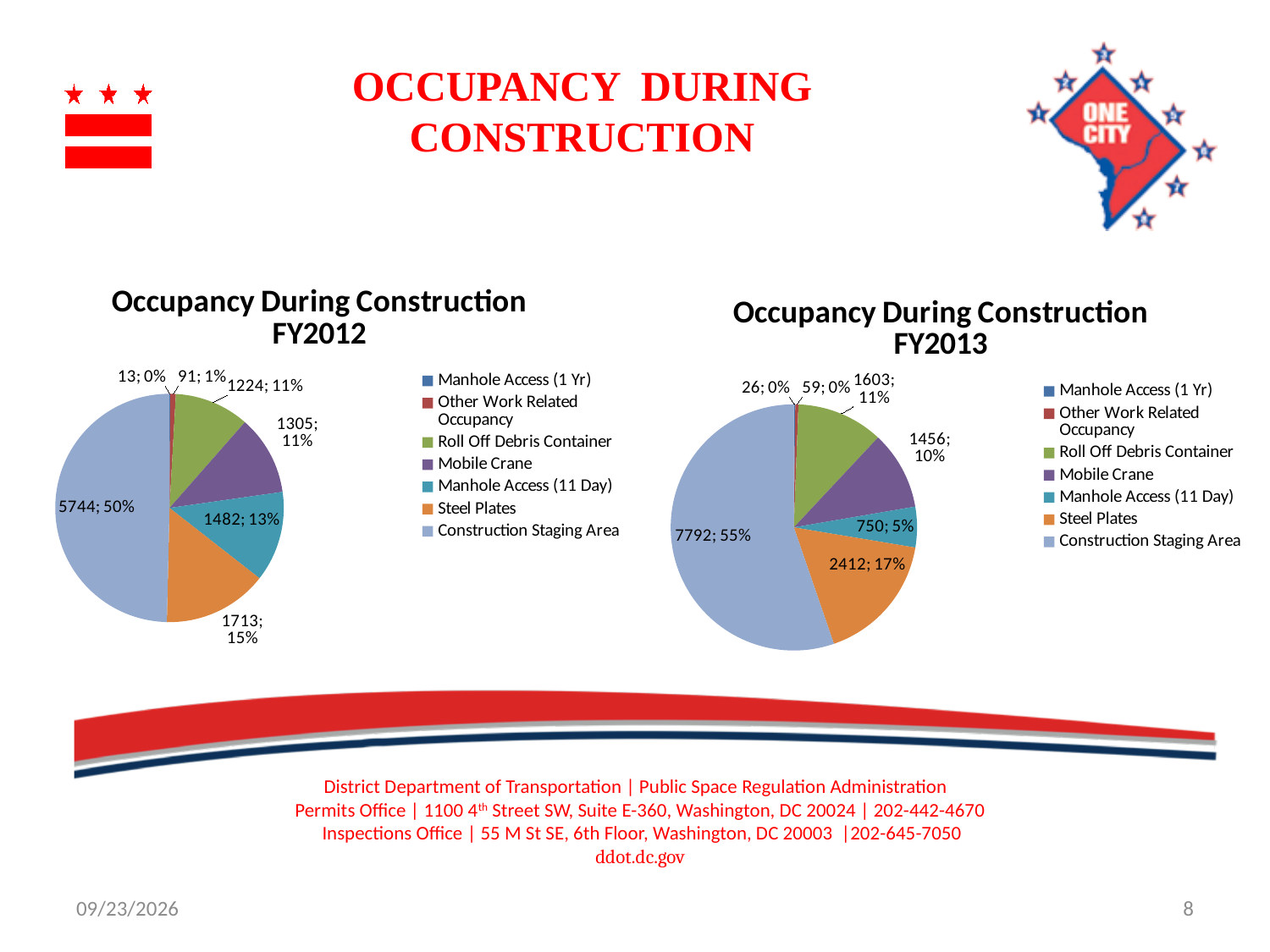
What type of chart is used for Occupancy During Construction FY2012? Pie chart In the Occupancy During Construction FY2012 chart, what is the difference between the Steel Plates value and the Manhole Access (11 Day) value? 231 In the Occupancy During Construction FY2013 chart, what value is shown for Steel Plates? 2412; 17% In the Occupancy During Construction FY2012 chart, which category has the largest slice? Construction Staging Area In the Occupancy During Construction FY2013 chart, which category has the largest slice? Construction Staging Area In the Occupancy During Construction FY2012 chart, what value is shown for Construction Staging Area? 5744; 50% In the Occupancy During Construction FY2013 chart, which is larger: Roll Off Debris Container or Mobile Crane? Roll Off Debris Container How many categories does the legend of the Occupancy During Construction FY2013 chart list? 7 What share of the Occupancy During Construction FY2013 pie does Construction Staging Area represent? 55% What share of the Occupancy During Construction FY2012 pie does Steel Plates represent? 15% In the Occupancy During Construction FY2013 chart, what value is shown for Manhole Access (11 Day)? 750; 5% In the Occupancy During Construction FY2012 chart, which category has the smallest slice? Manhole Access (1 Yr)